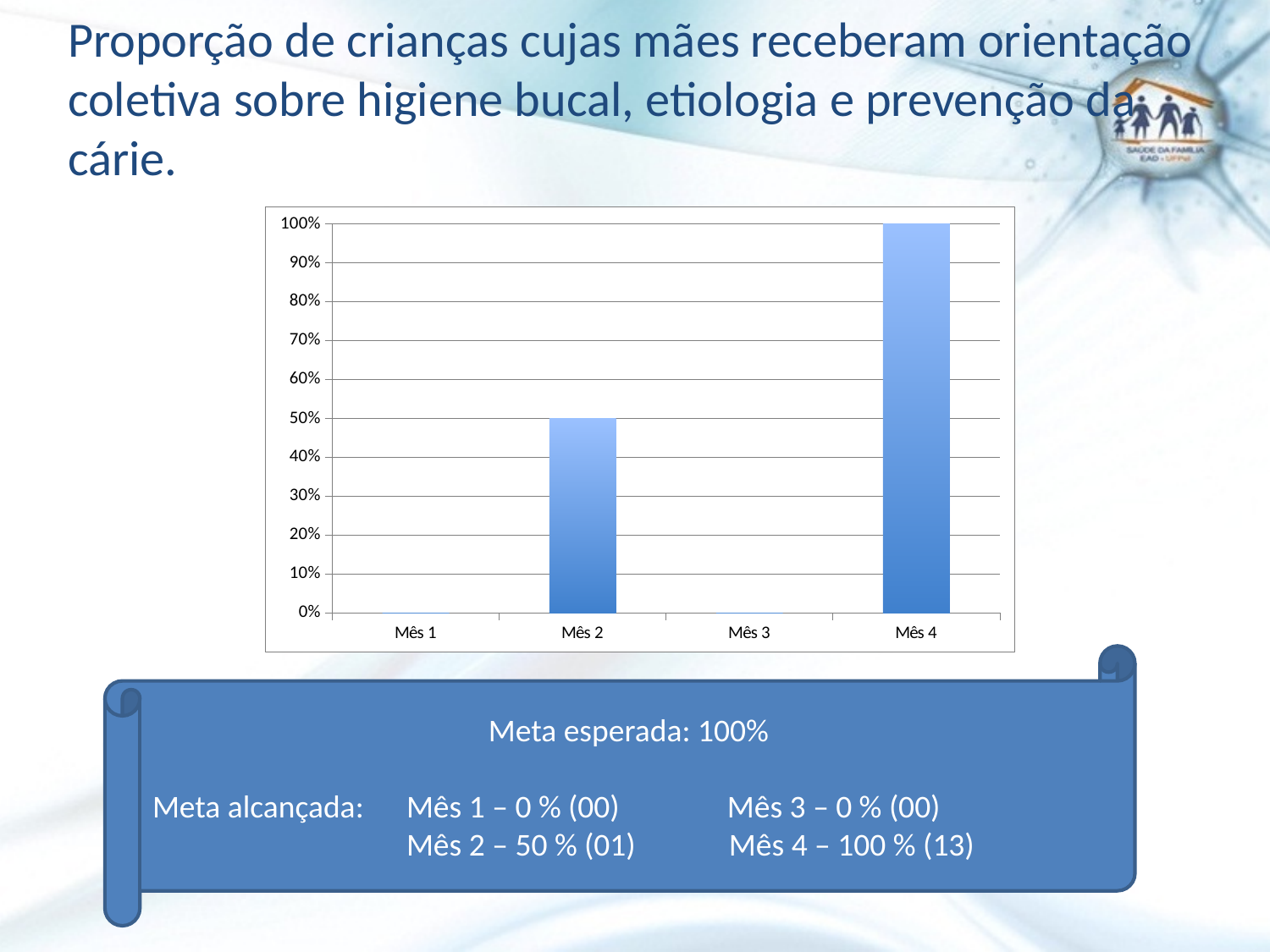
Which category has the highest value in the chart? Mês 4 What is the value for Mês 1 in the chart? 0% What is the difference between the values for Mês 4 and Mês 2? 50% Is the value for Mês 2 greater or less than 40%? greater Which is larger, the value for Mês 2 or the value for Mês 4? Mês 4 How many categories are shown on the x axis of the chart? 4 What is the value for Mês 2 in the chart? 50% What is the value for Mês 4 in the chart? 100% What type of chart is shown on the slide? bar chart What is the value for Mês 3 in the chart? 0% What is the expected target (Meta esperada) stated below the chart? 100% What is the highest value shown on the y axis of the chart? 100%